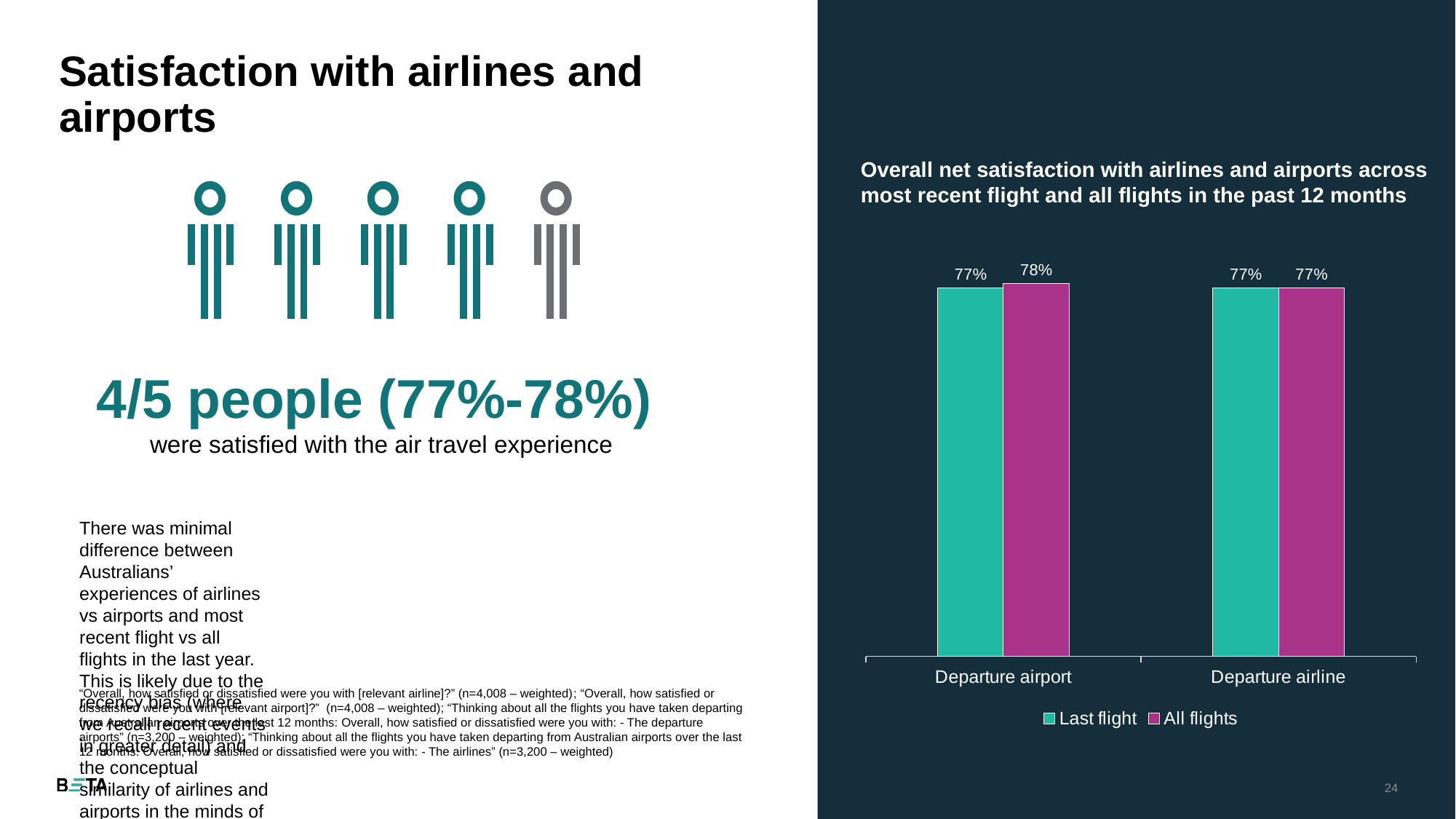
What colour are the All flights bars? Magenta/purple How many series does the legend list? 2 What type of chart is shown on the slide? Bar chart Which bar has the highest value in the chart? All flights for Departure airport (78%) What is the difference between the All flights and Last flight values for Departure airport? 1% What is the All flights value for Departure airline? 77% For Departure airport, which is larger: the Last flight value or the All flights value? All flights How many categories are shown on the x axis? 2 What is the title of the chart? Overall net satisfaction with airlines and airports across most recent flight and all flights in the past 12 months What is the Last flight value for Departure airport? 77% What is the All flights value for Departure airport? 78% What is the Last flight value for Departure airline? 77%